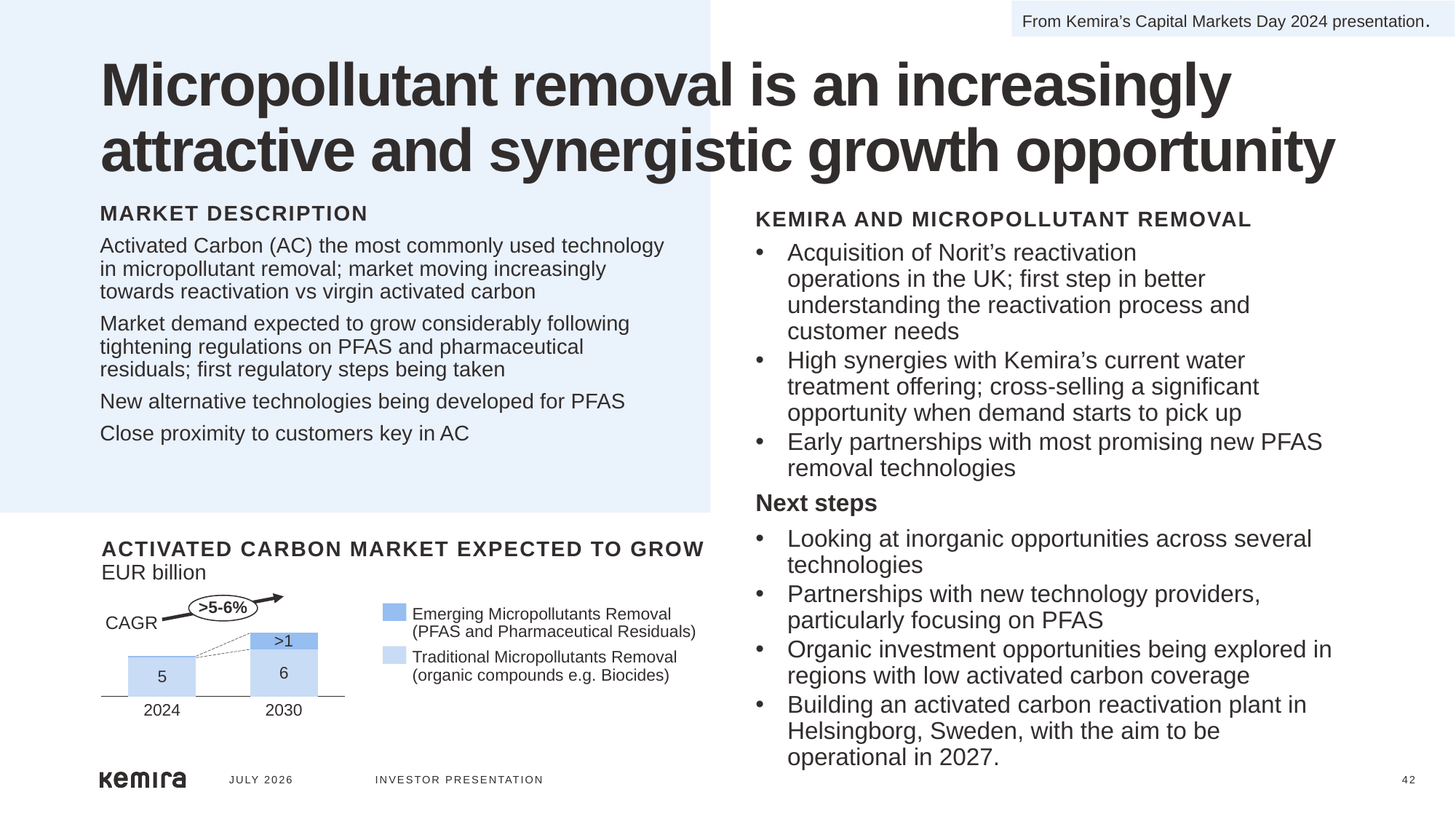
What is the value of the Traditional Micropollutants Removal segment for 2024 in the Activated Carbon Market chart? 5 What value is shown for the Emerging Micropollutants Removal segment in 2030? >1 Does the activated carbon market rise or fall from 2024 to 2030? Rise By how much does the Traditional Micropollutants Removal value grow from 2024 to 2030? 1 What kind of chart is used to show the activated carbon market? Stacked bar chart How many series does the legend of the Activated Carbon Market chart list? 2 In what unit are the values of the Activated Carbon Market chart expressed? EUR billion Which year has the larger Traditional Micropollutants Removal value, 2024 or 2030? 2030 What CAGR is shown on the Activated Carbon Market chart? >5-6% How many years (categories) are shown on the x axis of the Activated Carbon Market chart? 2 What is the value of the Traditional Micropollutants Removal segment for 2030 in the Activated Carbon Market chart? 6